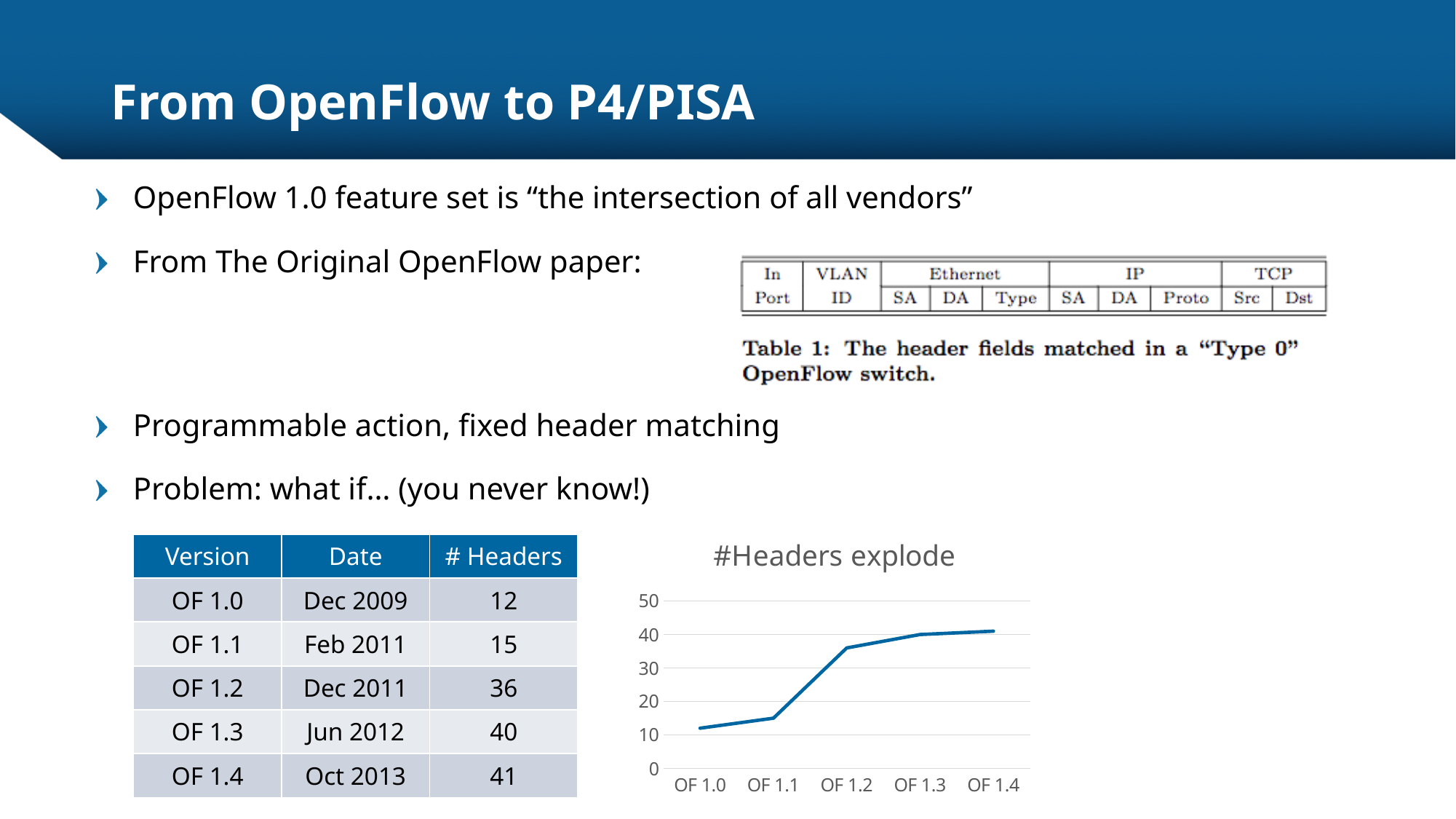
In the "#Headers explode" chart, which version has the highest number of headers? OF 1.4 In the "#Headers explode" chart, is the value for OF 1.2 greater or less than 30? greater What kind of chart is shown under the title "#Headers explode"? line chart In the "#Headers explode" chart, is the value for OF 1.1 greater or less than 20? less According to the slide, how many headers does OF 1.2 have? 36 In the "#Headers explode" chart, is the value for OF 1.4 greater or less than 50? less According to the slide, what is the difference in number of headers between OF 1.4 and OF 1.0? 29 In the "#Headers explode" chart, which has more headers, OF 1.1 or OF 1.2? OF 1.2 How many OpenFlow versions are plotted along the x axis of the "#Headers explode" chart? 5 In the "#Headers explode" chart, which version has the lowest number of headers? OF 1.0 Do the values in the "#Headers explode" chart rise or fall from OF 1.0 to OF 1.4? rise What is the title of the chart on the slide? #Headers explode